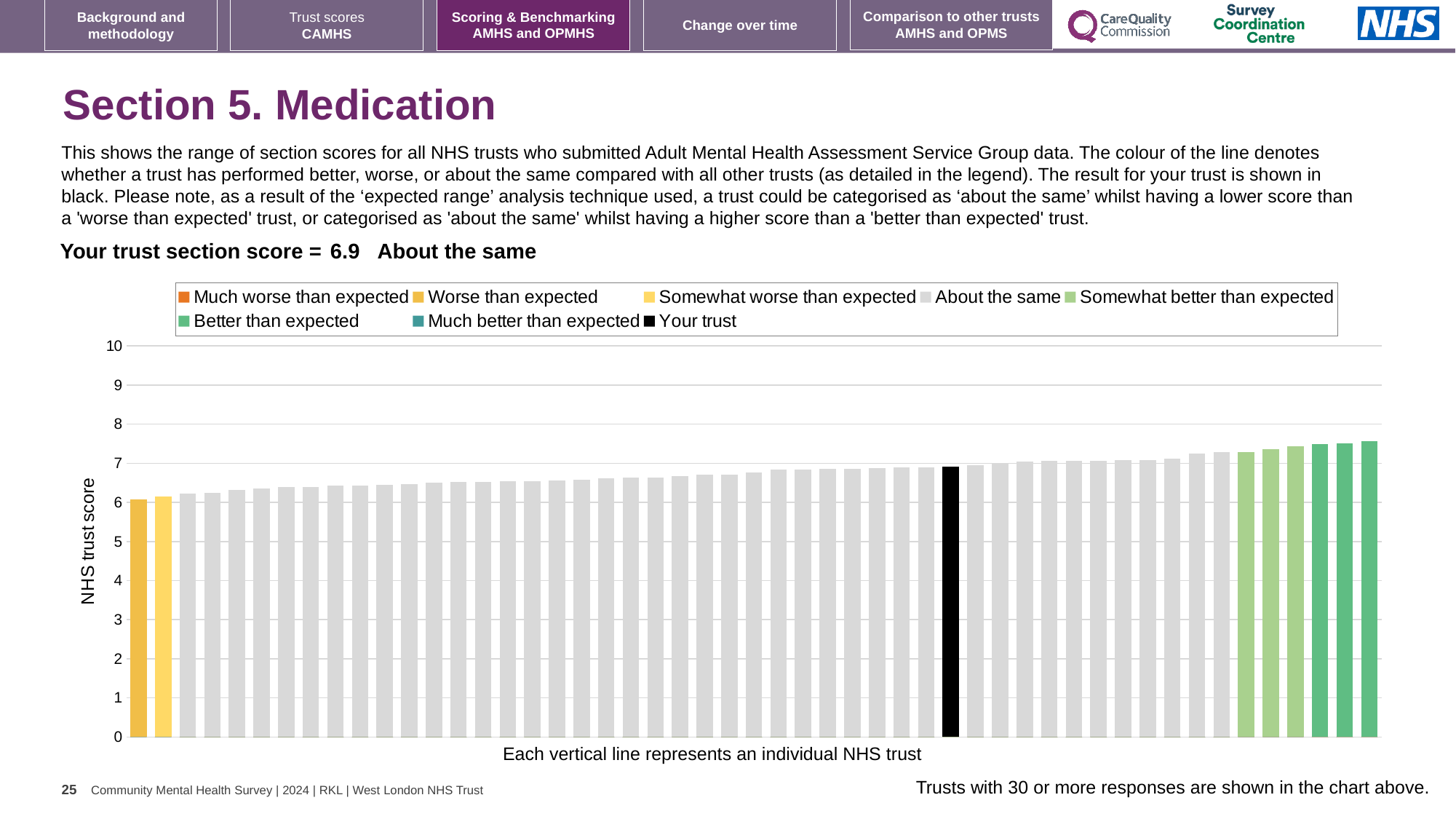
Is the 'Your trust' bar taller or shorter than the leftmost bar? taller Do the bar values rise or fall from left to right along the x axis? rise Which is taller, the leftmost bar or the rightmost bar? the rightmost bar Is the value of the black 'Your trust' bar greater or less than 5? greater How many entries does the chart legend list? 8 What is the section score for your trust shown on the slide? 6.9 What colour is used for the 'Your trust' bar in the chart? black What is the label on the vertical axis of the chart? NHS trust score Is the value of the tallest bar greater or less than 8? less What kind of chart is shown on the slide? bar chart Is the value of the leftmost (lowest) bar greater or less than 5? greater Which category is your trust placed in for this section? About the same